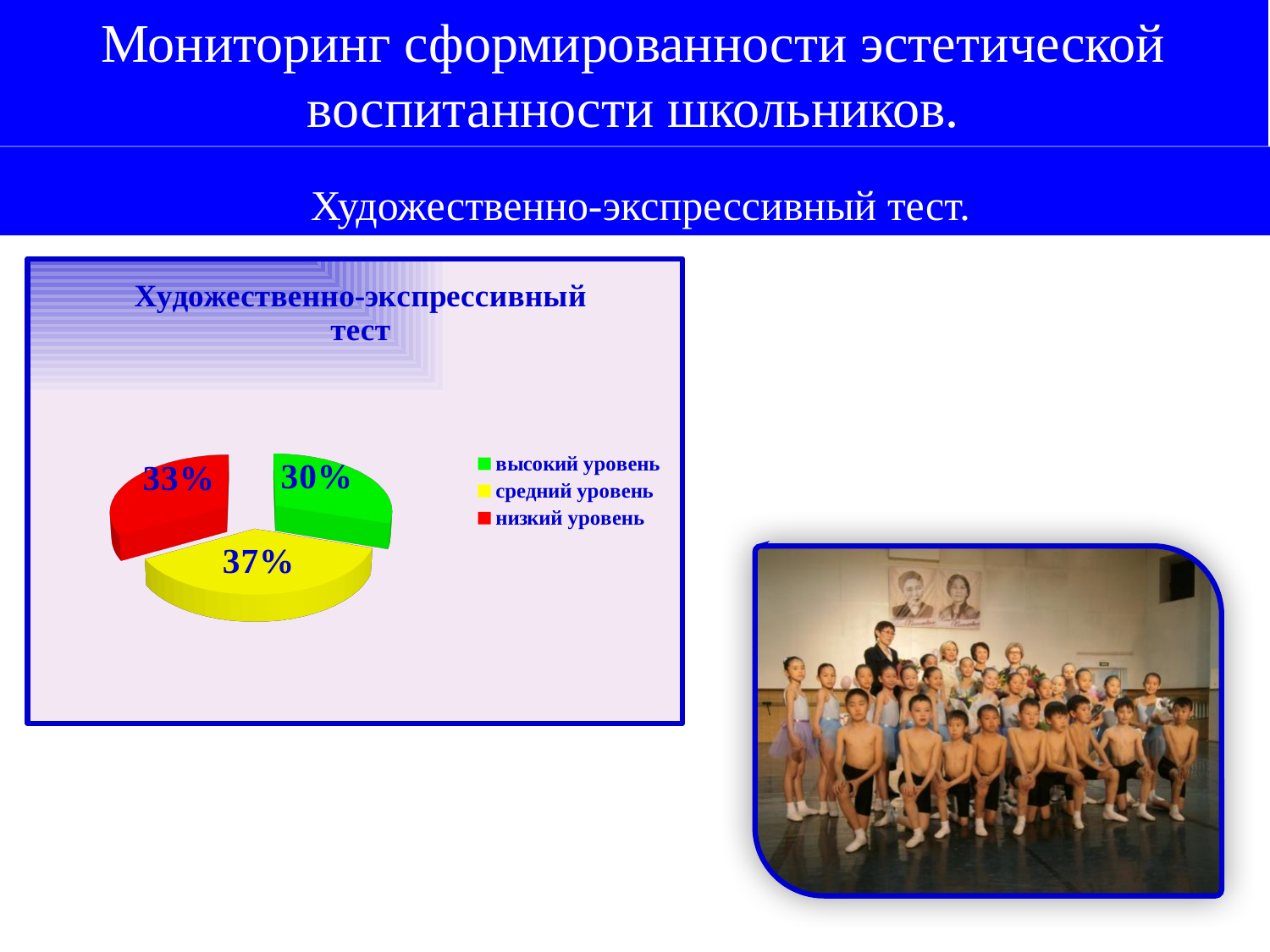
What kind of chart is shown on the slide? pie chart How many entries does the legend list? 3 What percentage is shown for высокий уровень? 30% What percentage is shown for низкий уровень? 33% Which level has the smallest share of the pie? высокий уровень What colour is the slice for низкий уровень? red Which level has the largest share of the pie? средний уровень What is the difference between the shares for средний уровень and высокий уровень? 7% What is the title of the chart? Художественно-экспрессивный тест What percentage is shown for средний уровень? 37% Which is larger, the share for низкий уровень or the share for высокий уровень? низкий уровень How many slices does the pie chart have? 3